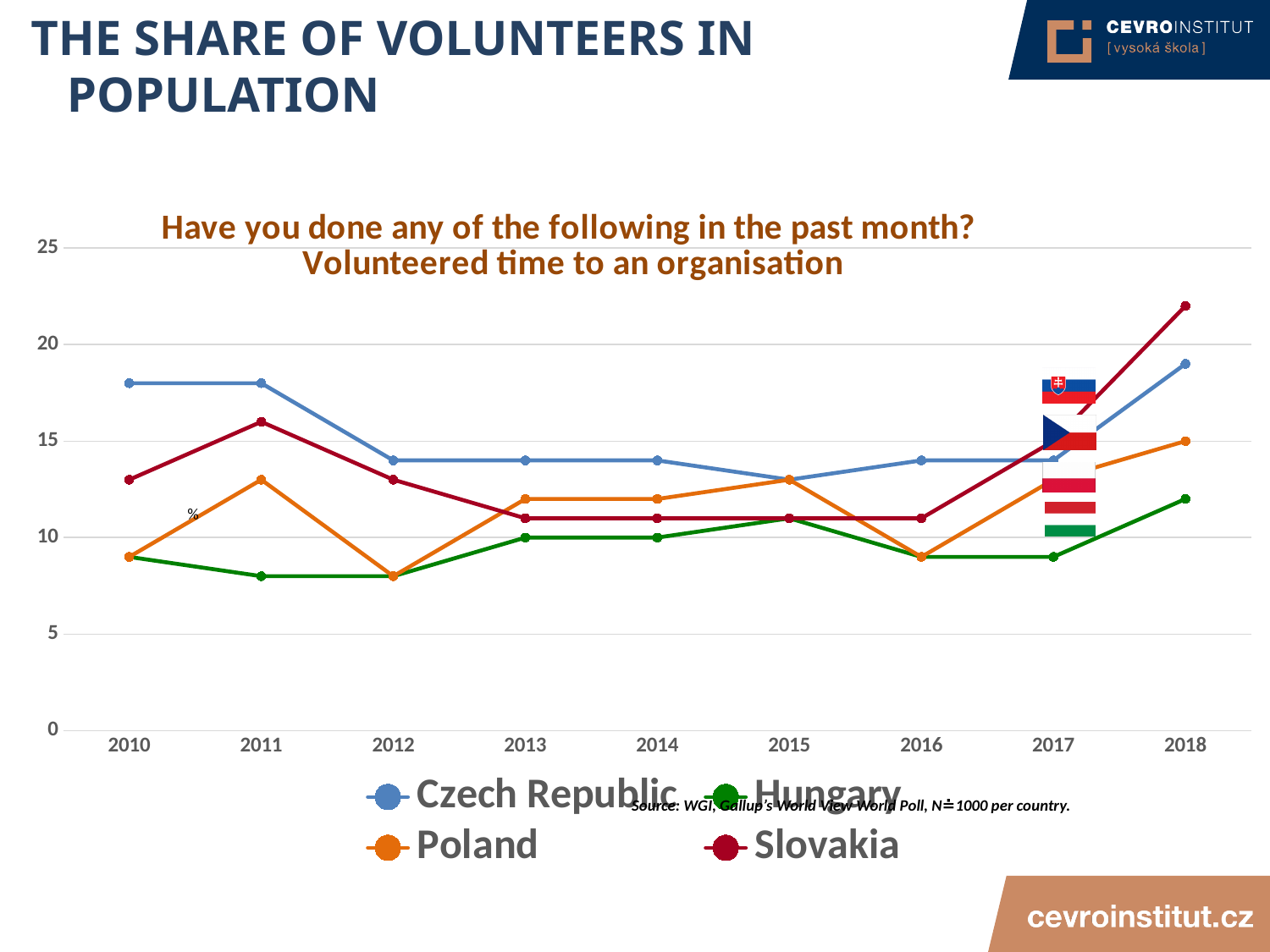
In 2010, which is higher: the Czech Republic or Slovakia? Czech Republic How many series does the legend list? 4 Does the Czech Republic line rise or fall from 2011 to 2012? fall Is the value for Hungary in 2011 greater or less than 10? less Is the value for Poland in 2012 greater or less than 10? less What kind of chart is shown on the slide? line chart Is the value for Slovakia in 2018 greater or less than 20? greater Which four countries are listed in the legend? Czech Republic, Hungary, Poland, Slovakia Which country has the highest value in 2018? Slovakia Which country has the lowest value in 2018? Hungary How many years are shown on the x axis? 9